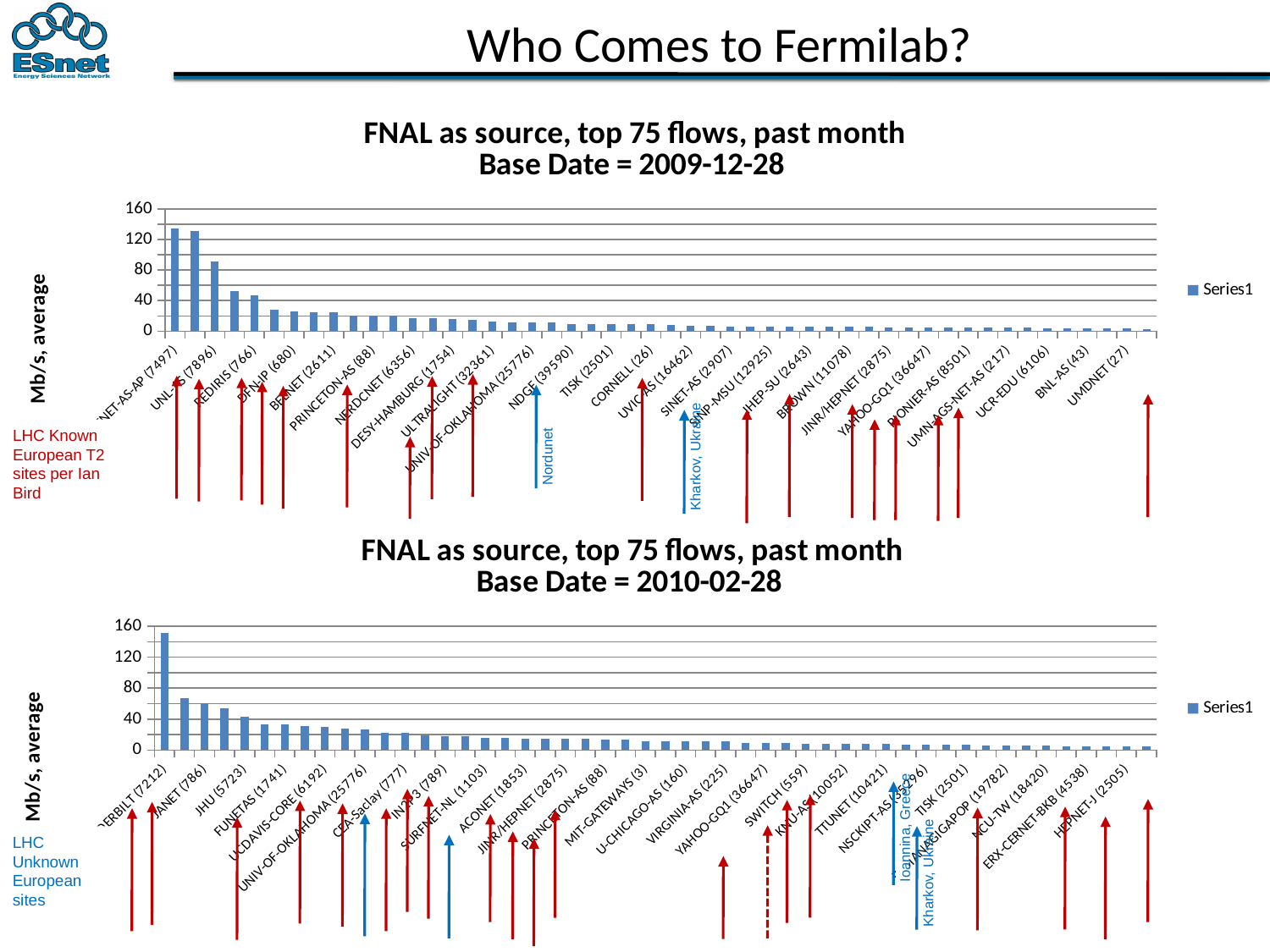
In the top chart (Base Date = 2009-12-28), is the value of the tallest bar greater or less than 120? greater In the bottom chart (Base Date = 2010-02-28), do the bar values rise or fall from left to right along the x axis? fall In the top chart (Base Date = 2009-12-28), do the bar values rise or fall from left to right along the x axis? fall What kind of chart is the bottom chart (Base Date = 2010-02-28)? bar chart What kind of chart is the top chart (Base Date = 2009-12-28)? bar chart In the bottom chart (Base Date = 2010-02-28), is the value of the second-tallest bar greater or less than 80? less Which chart has the taller tallest bar, the top chart (Base Date = 2009-12-28) or the bottom chart (Base Date = 2010-02-28)? the bottom chart (Base Date = 2010-02-28) In the bottom chart (Base Date = 2010-02-28), is the value of the tallest bar greater or less than 120? greater What base date is given in the title of the top chart? 2009-12-28 How many series does the legend of the bottom chart (Base Date = 2010-02-28) list? 1 What is the y-axis label of the top chart (Base Date = 2009-12-28)? Mb/s, average How many series does the legend of the top chart (Base Date = 2009-12-28) list? 1